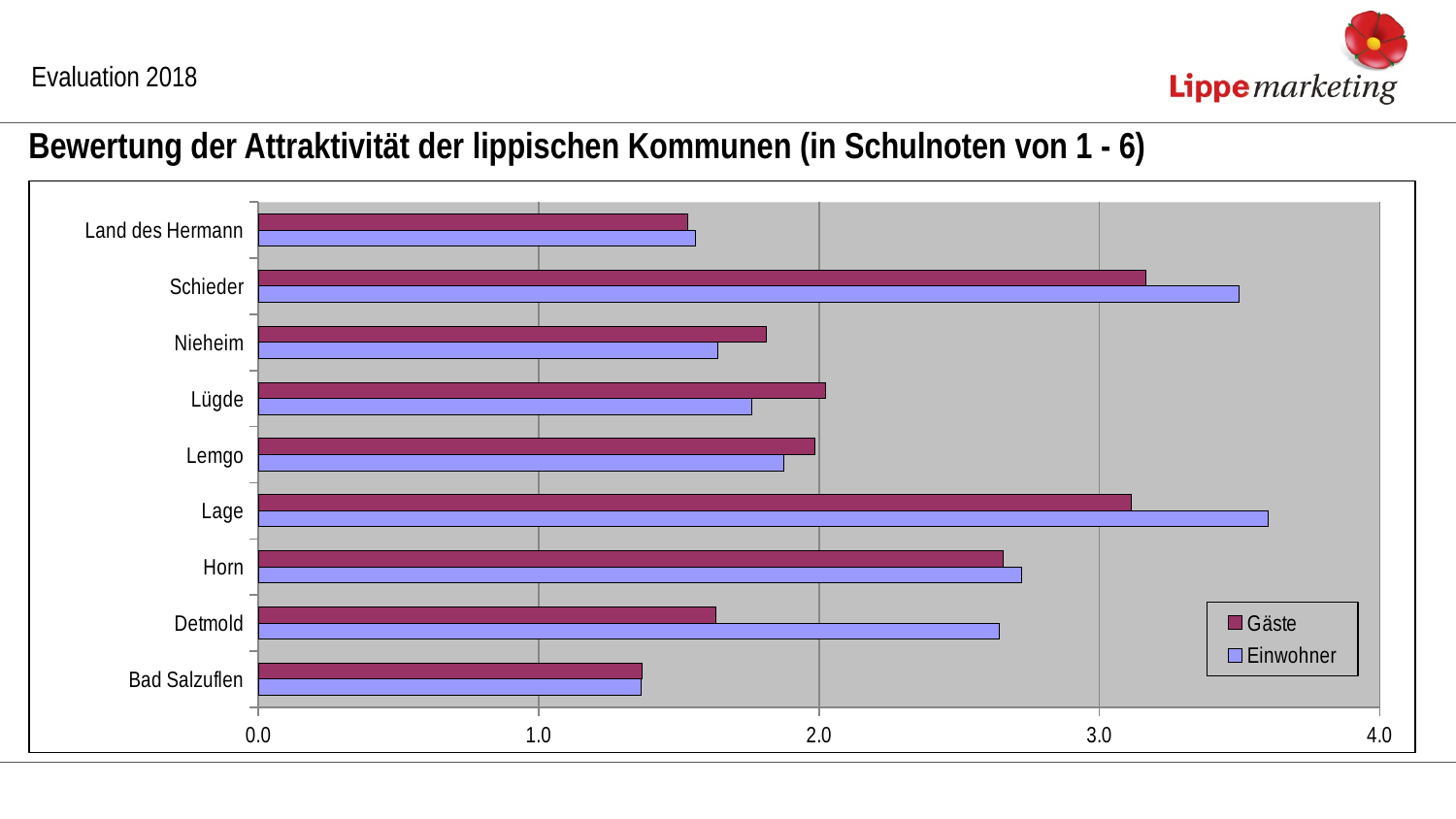
Which commune has the lowest Gäste value? Bad Salzuflen Is the Gäste value for Bad Salzuflen greater or less than 2.0? less How many series does the legend list? 2 Which commune has the highest Einwohner value? Lage Is the Gäste value for Schieder greater or less than 3.0? greater How many communes (categories) are listed on the chart? 9 Is the Einwohner value for Lage greater or less than 3.0? greater For Detmold, which is larger: the Gäste value or the Einwohner value? Einwohner For Lügde, which is larger: the Gäste value or the Einwohner value? Gäste Which series is shown in dark red in the legend? Gäste What kind of chart is shown on the slide? bar chart